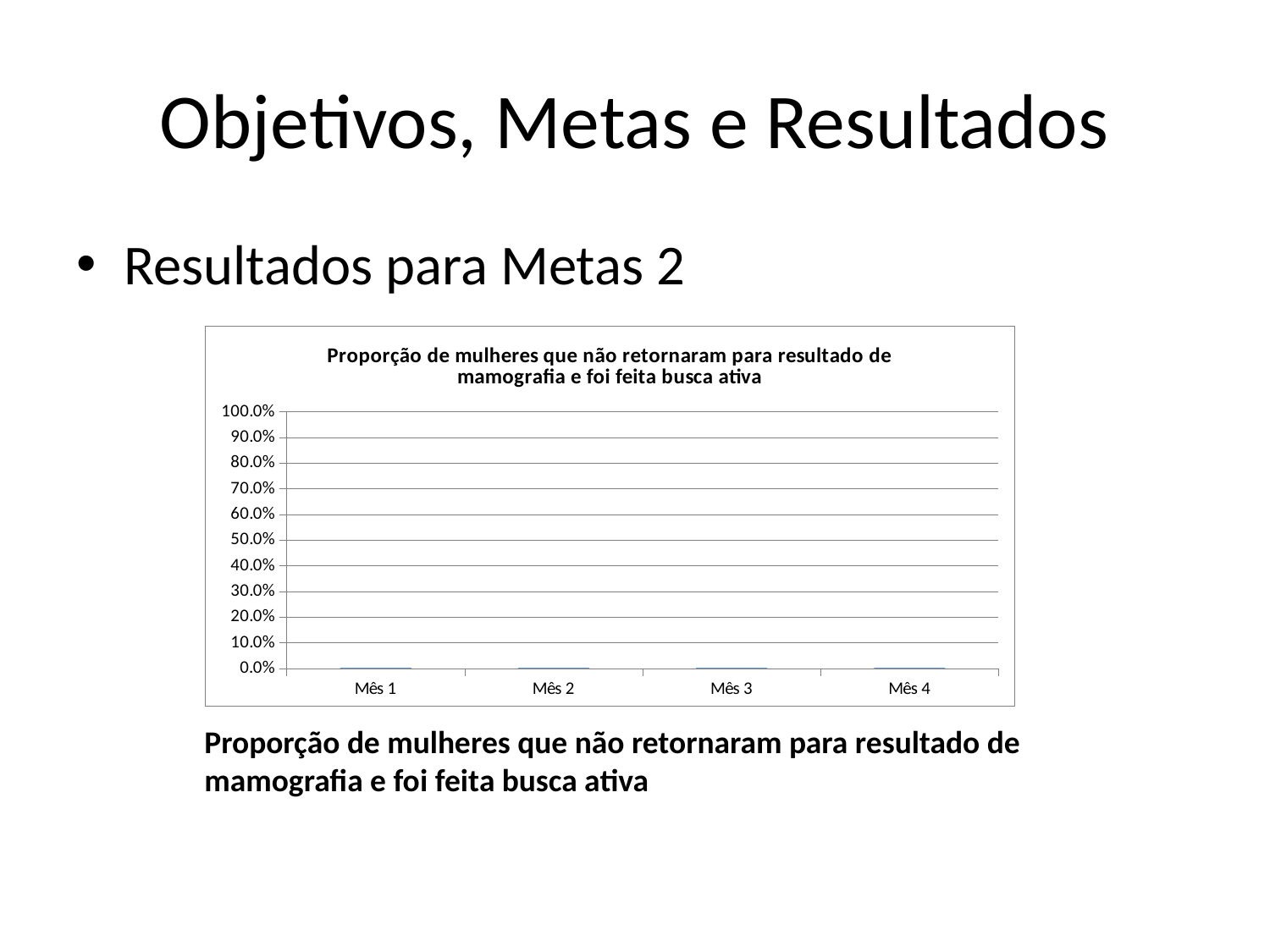
How many categories are shown on the x axis of the chart? 4 What is the title of the chart? Proporção de mulheres que não retornaram para resultado de mamografia e foi feita busca ativa What kind of chart is shown on the slide? bar chart Is the value for Mês 3 greater or less than 50.0%? less What is the label of the last category on the x axis? Mês 4 What is the highest value shown on the y axis of the chart? 100.0% Is the value for Mês 2 greater or less than 10.0%? less Is the value for Mês 4 greater or less than 20.0%? less What is the label of the first category on the x axis? Mês 1